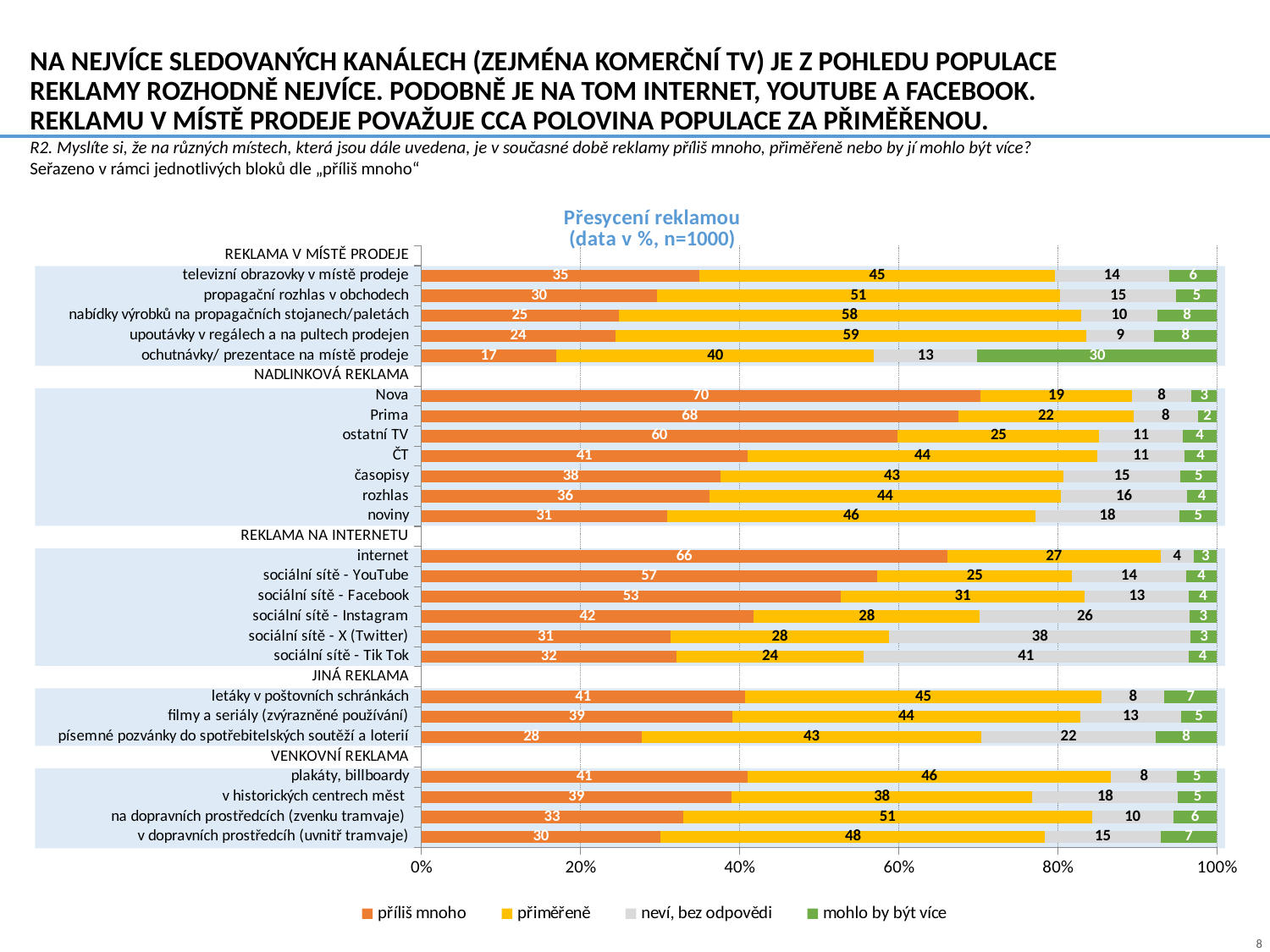
How many series does the legend list? 4 Which category has the highest value for "příliš mnoho"? Nova What is the total of the stacked bar for Nova? 100 Which has a larger "přiměřeně" value: internet or sociální sítě - Facebook? sociální sítě - Facebook Which category has the lowest value for "příliš mnoho"? ochutnávky/ prezentace na místě prodeje What kind of chart is shown on the slide? Stacked bar chart What is the value of "neví, bez odpovědi" for "sociální sítě - Tik Tok"? 41 How many categories are listed in the "REKLAMA NA INTERNETU" block? 6 What is the title of the chart? Přesycení reklamou (data v %, n=1000) What is the value of "příliš mnoho" for Nova? 70 What is the difference between the "příliš mnoho" values for Nova and Prima? 2 What is the value of "mohlo by být více" for "ochutnávky/ prezentace na místě prodeje"? 30